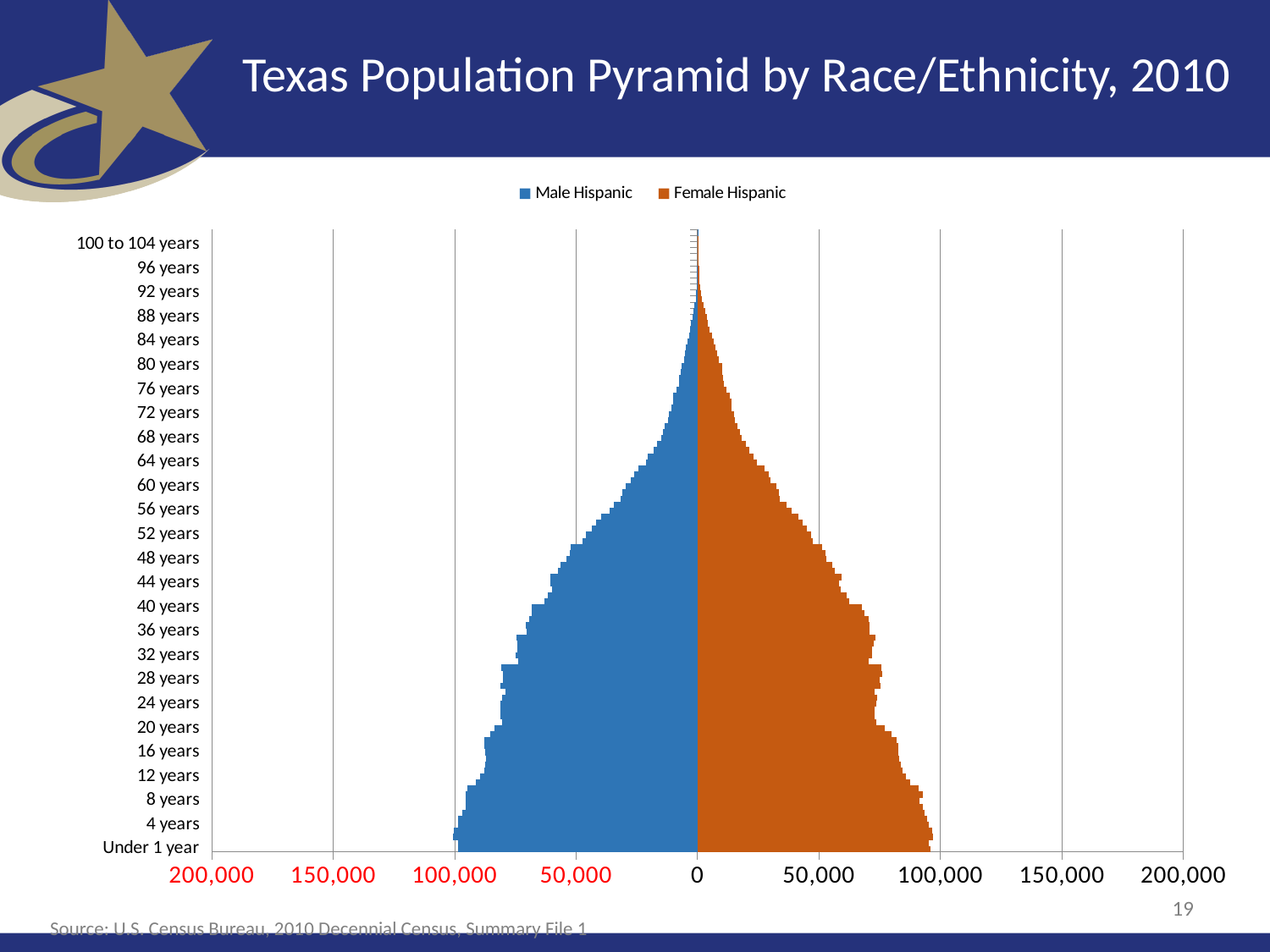
Which is larger, the Female Hispanic value for 36 years or for 72 years? 36 years Which colour represents the Female Hispanic series? Orange Is the Male Hispanic value for 20 years greater or less than 100,000? less What are the two series named in the legend? Male Hispanic and Female Hispanic Do the Female Hispanic values generally rise or fall as age increases from Under 1 year to 100 to 104 years? fall Is the Female Hispanic value for 80 years greater or less than 50,000? less Is the Female Hispanic value for 40 years greater or less than 50,000? greater Which is larger, the Male Hispanic value for 20 years or for 60 years? 20 years What kind of chart is shown on the slide? Bar chart (population pyramid) How many series does the legend list? 2